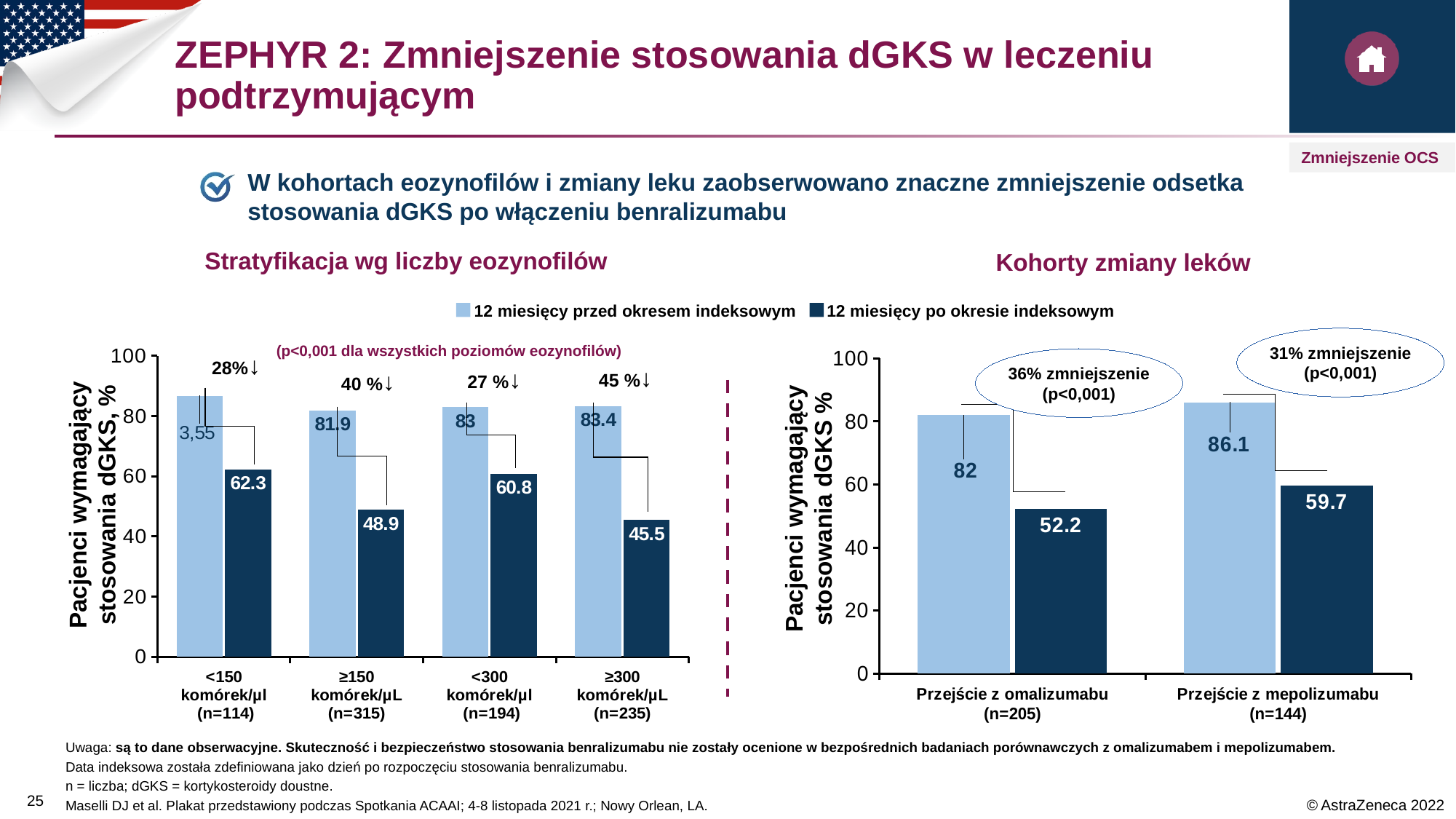
In the 'Stratyfikacja wg liczby eozynofilów' chart, which category has the highest value in the 12 months after the index period? <150 komórek/µl In the 'Kohorty zmiany leków' chart, what is the value for 'Przejście z mepolizumabu' in the 12 months before the index period? 86.1 In the 'Kohorty zmiany leków' chart, what is the difference between the before and after values for 'Przejście z mepolizumabu'? 26.4 In the 'Stratyfikacja wg liczby eozynofilów' chart, what is the value for '≥300 komórek/µL' in the 12 months after the index period? 45.5 How many series does the legend list for the charts on this slide? 2 In the 'Kohorty zmiany leków' chart, which is larger: the after value for 'Przejście z omalizumabu' or the after value for 'Przejście z mepolizumabu'? Przejście z mepolizumabu In the 'Stratyfikacja wg liczby eozynofilów' chart, which category has the lowest value in the 12 months after the index period? ≥300 komórek/µL How many categories are shown on the x axis of the 'Stratyfikacja wg liczby eozynofilów' chart? 4 In the 'Stratyfikacja wg liczby eozynofilów' chart, what is the difference between the before and after values for '<300 komórek/µl'? 22.2 What kind of chart is the 'Kohorty zmiany leków' chart? Bar chart In the 'Kohorty zmiany leków' chart, what is the value for 'Przejście z omalizumabu' in the 12 months after the index period? 52.2 In the 'Stratyfikacja wg liczby eozynofilów' chart, what is the value for '≥150 komórek/µL' in the 12 months before the index period? 81.9